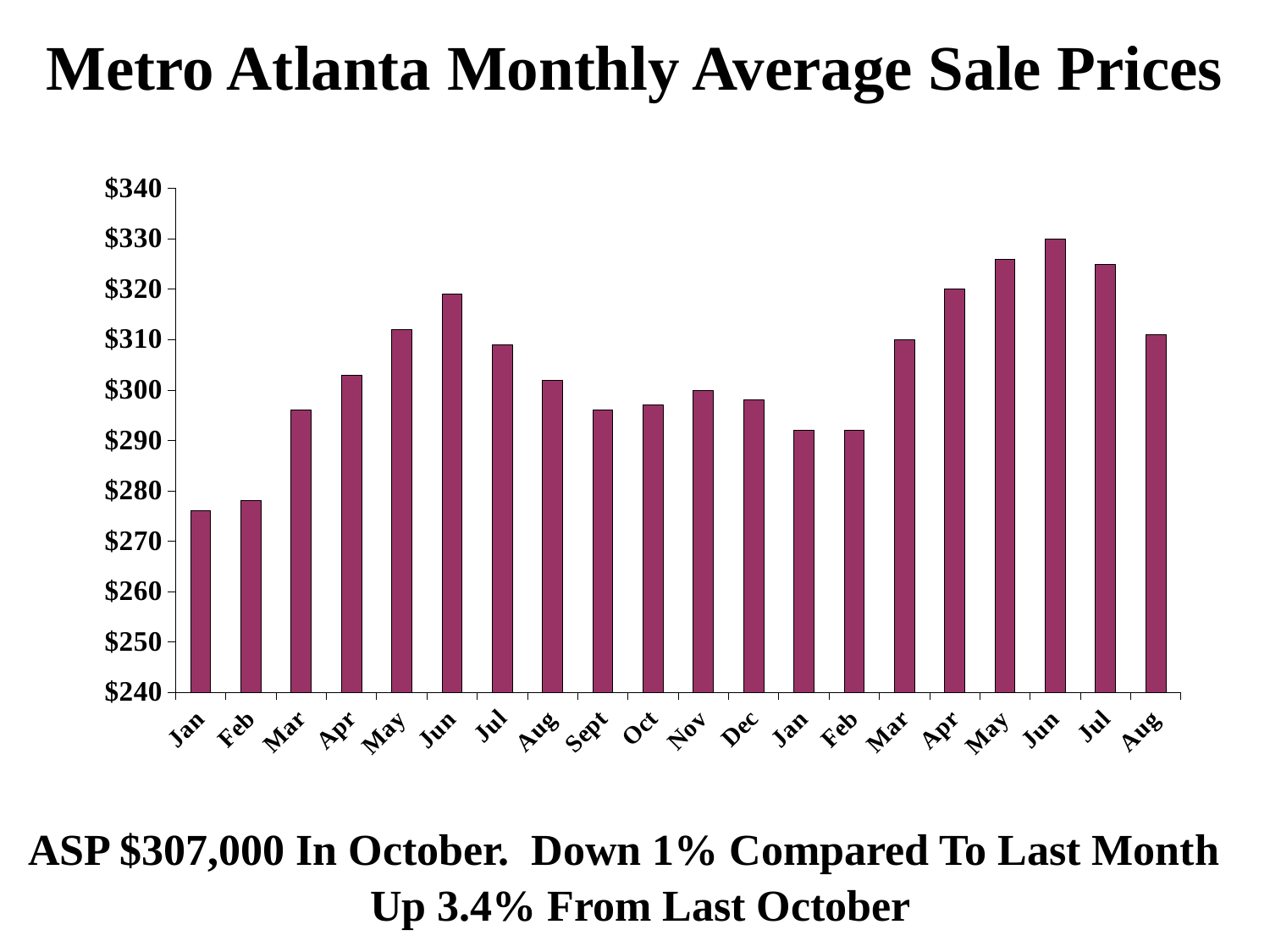
Which month has the lowest bar in the chart? Jan (the first Jan) Do the values rise or fall from the first Jan through the first Jun? rise Is the value for the first Jan bar greater or less than $280? less What is the value for Nov? $300 How many bars (months) are plotted in the chart? 20 Is the value for the first May bar greater or less than $310? greater Which month has the highest bar in the chart? Jun (the second Jun) What is the value for the second Jun bar? $330 What kind of chart is shown on the slide? bar chart Which is larger, the first Mar bar or the second Mar bar? the second Mar bar What is the title of the chart? Metro Atlanta Monthly Average Sale Prices What is the value for the second Apr bar? $320